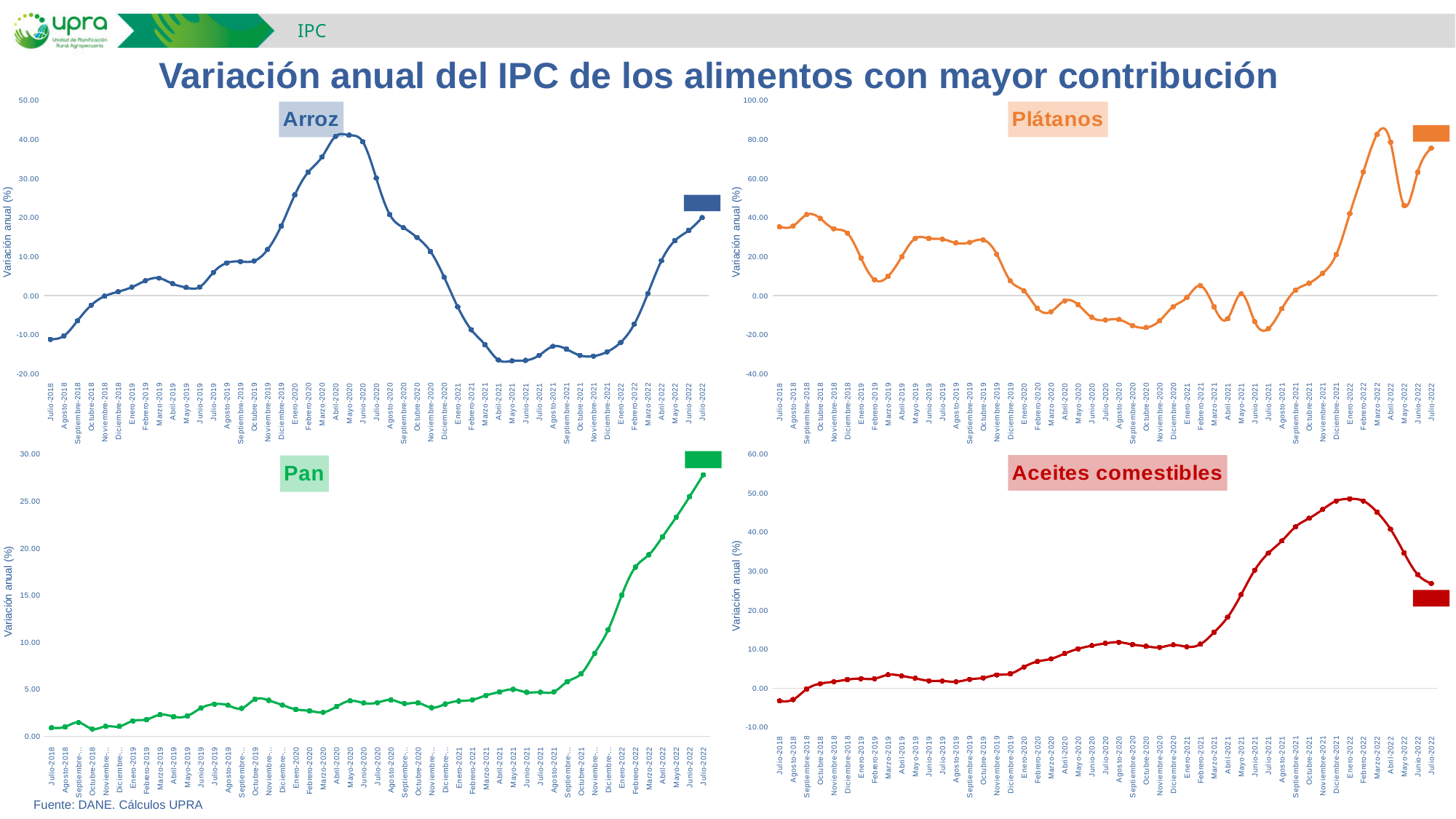
What is the label on the vertical axis of the Pan chart? Variación anual (%) In the Arroz chart, is the value for Mayo-2021 greater or less than -10.00? less In the Pan chart, is the value for Julio-2018 greater or less than 5.00? less In the Pan chart, is the value for Julio-2022 greater or less than 25.00? greater How many charts are shown on the slide? 4 In the Aceites comestibles chart, which is larger, the value for Febrero-2022 or the value for Julio-2022? Febrero-2022 In the Pan chart, which month has the highest value? Julio-2022 What kind of chart is used for the Arroz panel? line chart